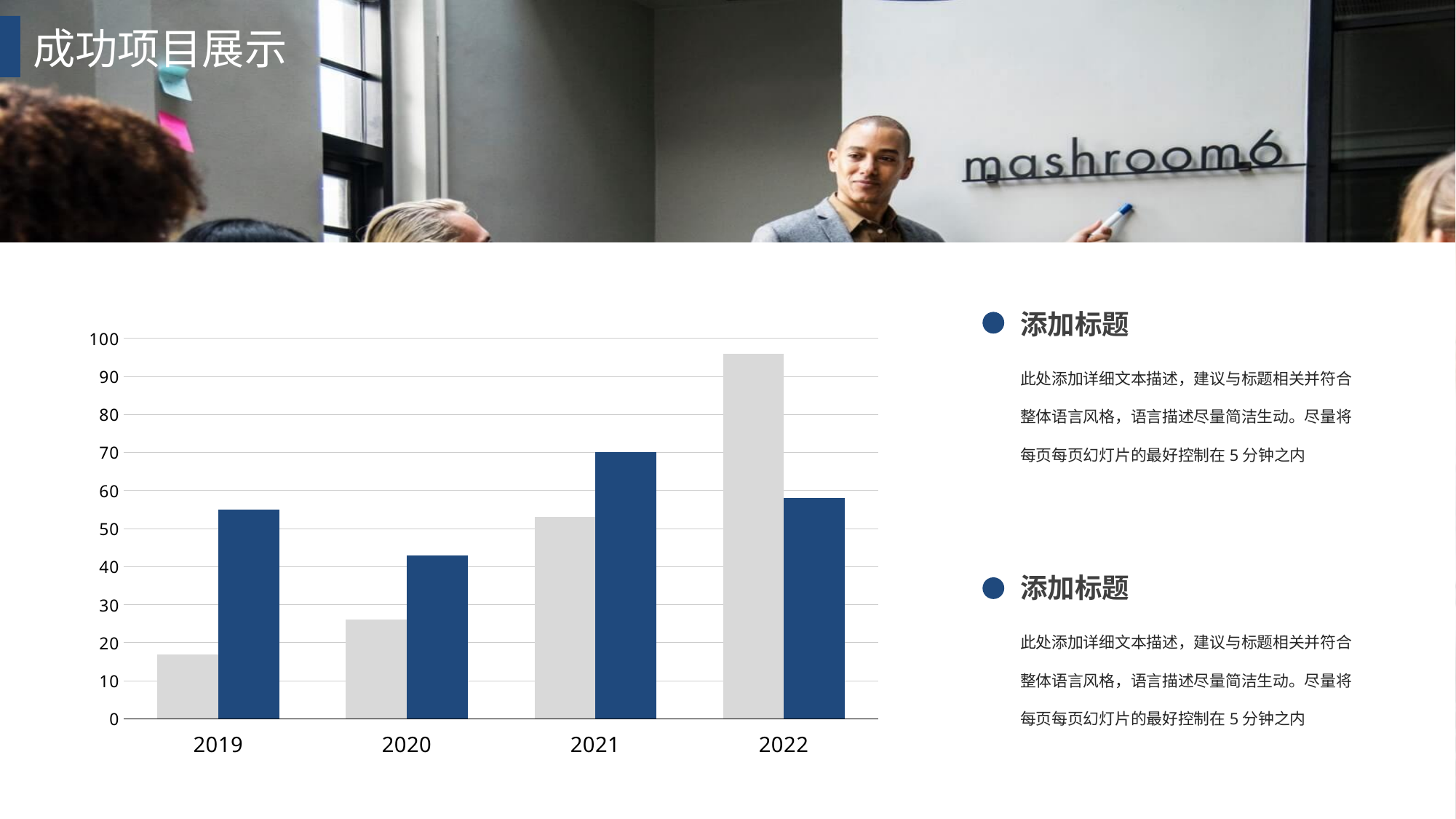
Do the grey bars rise or fall from 2019 to 2022? rise Which year has the shortest blue bar? 2020 Which year has the shortest grey bar? 2019 Is the grey bar for 2019 greater or less than 20? less In 2019, which bar is taller, the grey bar or the blue bar? the blue bar In 2022, which bar is taller, the grey bar or the blue bar? the grey bar Is the grey bar for 2022 greater or less than 90? greater What kind of chart is shown on the slide? bar chart Which year has the tallest blue bar? 2021 Which year has the tallest grey bar? 2022 How many years are shown on the x axis of the chart? 4 Is the blue bar for 2020 greater or less than 40? greater